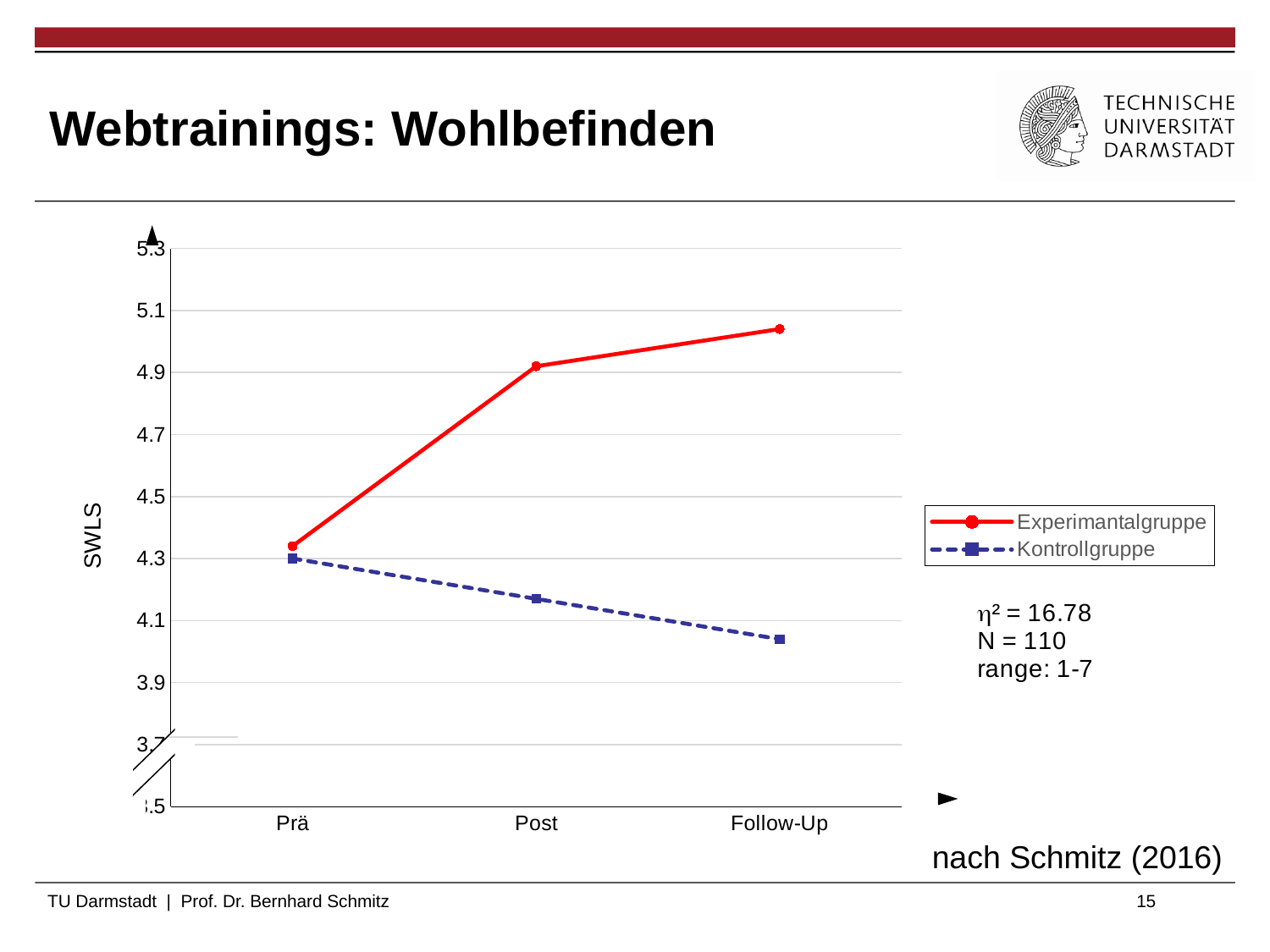
At which time point is the Kontrollgruppe value lowest? Follow-Up How many series does the legend list? 2 Is the value for the Experimantalgruppe at Post greater or less than 4.7? greater At Follow-Up, which group has the higher SWLS value, Experimantalgruppe or Kontrollgruppe? Experimantalgruppe Is the value for the Kontrollgruppe at Follow-Up greater or less than 4.1? less Is the value for the Experimantalgruppe at Prä greater or less than 4.5? less At which time point is the Experimantalgruppe value highest? Follow-Up Do the values for the Experimantalgruppe rise or fall from Prä to Follow-Up? rise What is the label on the y axis of the chart? SWLS Do the values for the Kontrollgruppe rise or fall from Prä to Follow-Up? fall What kind of chart is shown on the slide? line chart How many measurement points are shown along the x axis? 3